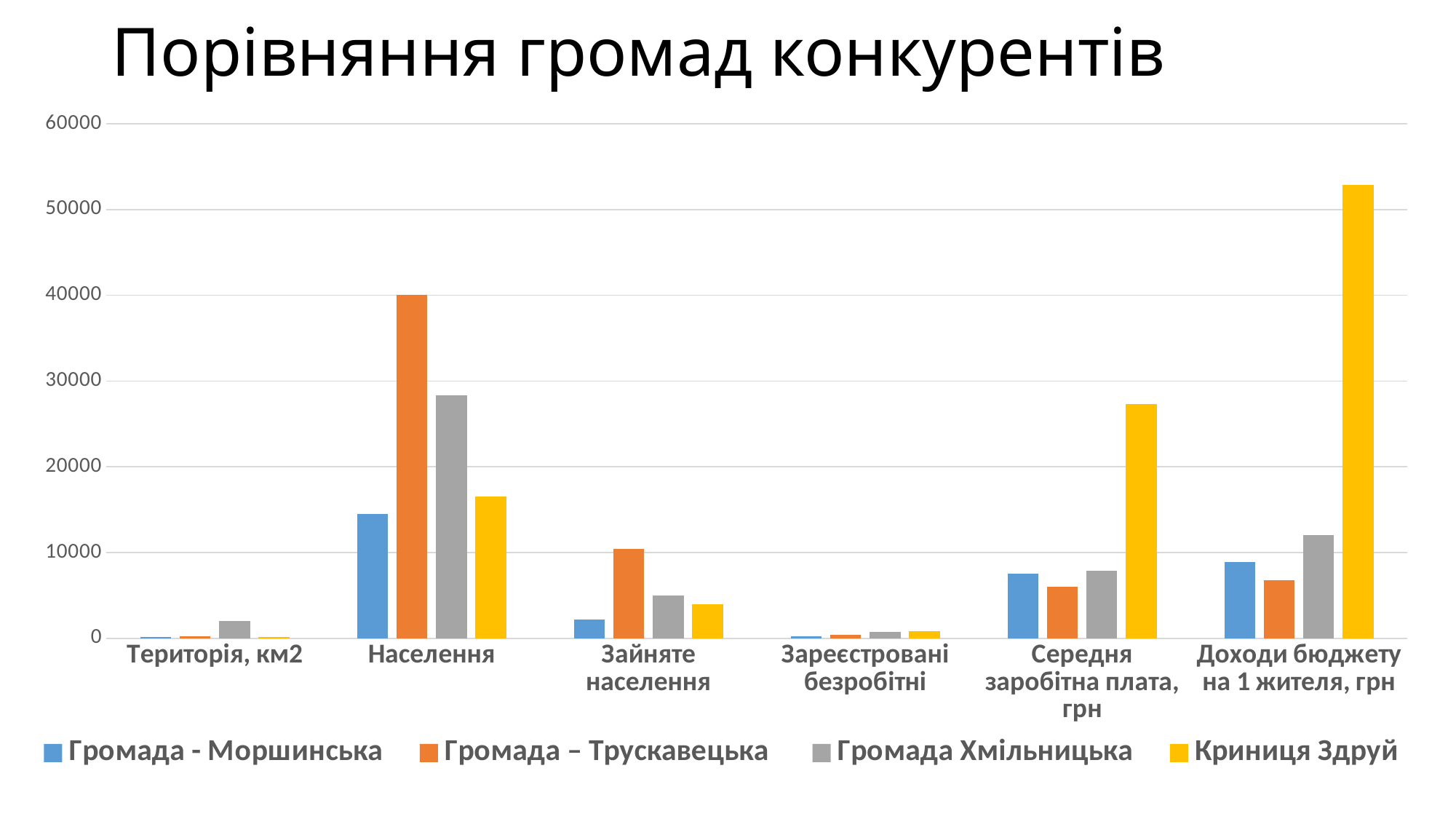
Which series has the lowest value for Населення? Громада - Моршинська Is the value for Криниця Здруй in Доходи бюджету на 1 жителя, грн greater or less than 50000? greater Which colour represents Криниця Здруй in the legend? yellow Which series has the highest value for Доходи бюджету на 1 жителя, грн? Криниця Здруй How many categories are shown along the x axis? 6 What is the title of the slide? Порівняння громад конкурентів Which series has the highest value for Населення? Громада – Трускавецька For Населення, which is larger: Громада Хмільницька or Криниця Здруй? Громада Хмільницька Is the value for Криниця Здруй in Середня заробітна плата, грн greater or less than 20000? greater How many series does the legend list? 4 Is the value for Громада – Трускавецька in Населення greater or less than 30000? greater What kind of chart is shown on the slide? bar chart